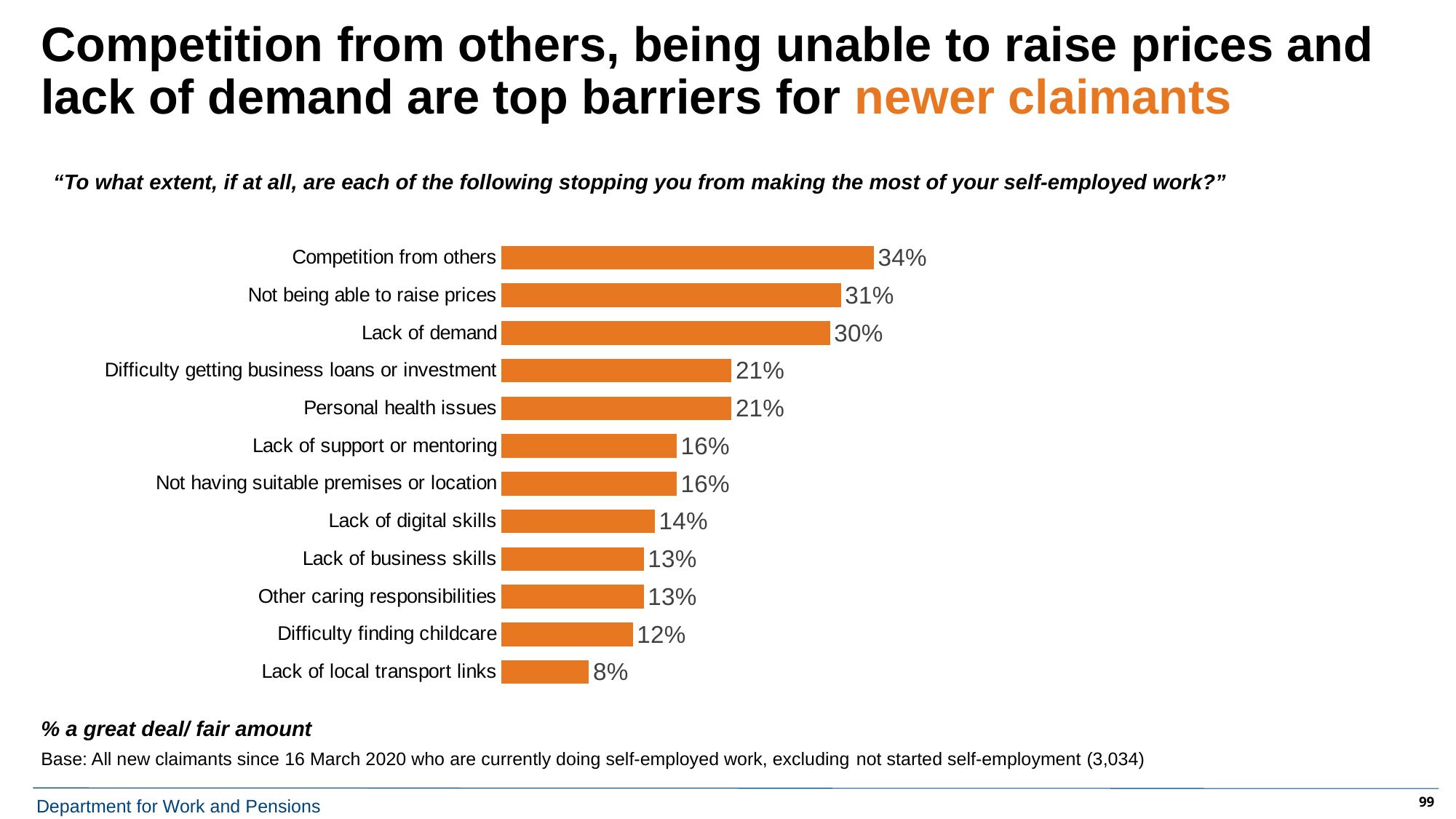
Which barrier has the highest percentage on the chart? Competition from others What is the value shown for 'Difficulty finding childcare'? 12% Which barrier has the lowest percentage on the chart? Lack of local transport links What percentage of newer claimants said competition from others was stopping them a great deal or fair amount? 34% What is the value shown for 'Lack of digital skills'? 14% What colour are the bars on the chart? Orange What type of chart is shown on the slide? Bar chart Which is larger: the value for 'Lack of support or mentoring' or the value for 'Lack of business skills'? Lack of support or mentoring What is the difference in percentage points between 'Not being able to raise prices' and 'Lack of demand'? 1 What is the value shown for 'Personal health issues'? 21% What is the difference in percentage points between 'Competition from others' and 'Lack of local transport links'? 26 How many barriers are listed on the chart? 12